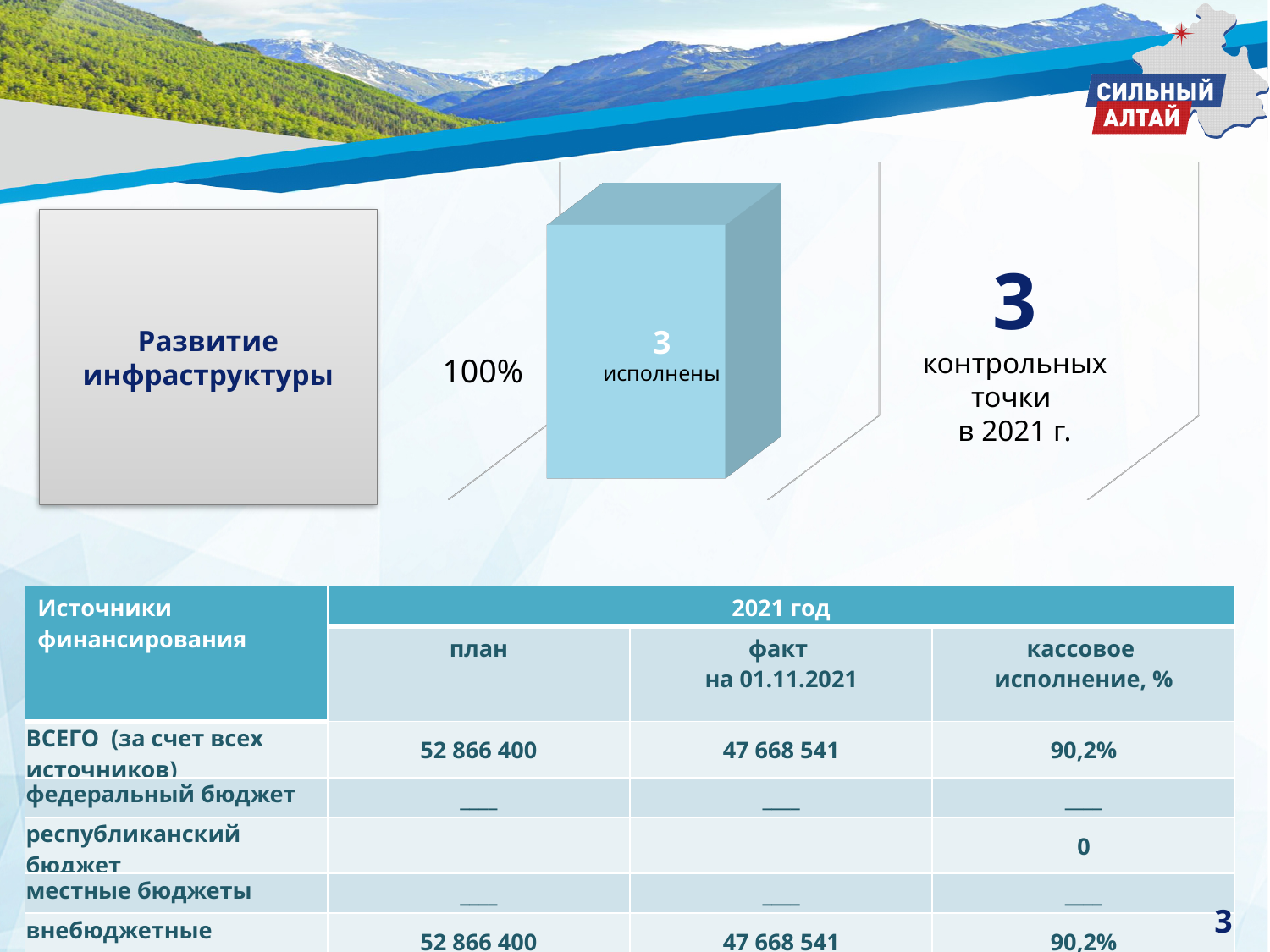
What kind of chart is shown in the middle of the slide? bar chart What word is printed on the bar below the number 3? исполнены What text is in the grey box to the left of the chart? Развитие инфраструктуры Is the value shown on the bar greater or less than 2? greater What percentage is shown to the left of the bar? 100% What value is printed on the bar in the chart? 3 How many bars does the chart show? 1